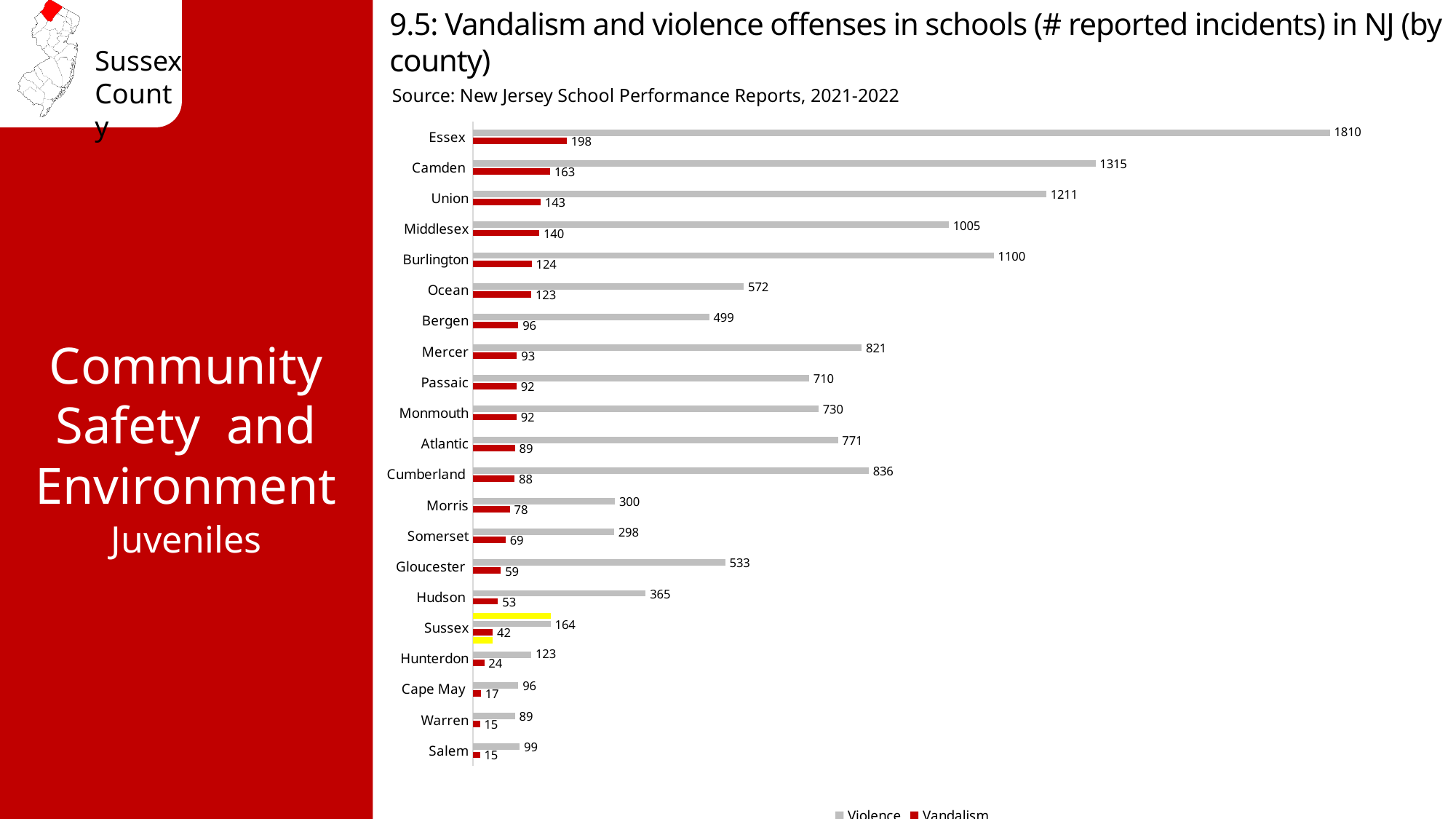
What is the Violence value for Essex? 1810 Which series is shown in red? Vandalism Which county has the highest Violence value? Essex Which is larger, the Violence value for Middlesex or for Burlington? Burlington How many series does the legend list? 2 Which county has the lowest Vandalism value? Warren and Salem (15 each) How many counties are shown on the chart? 21 What is the Violence value for Hunterdon? 123 What is the Vandalism value for Sussex? 42 What is the total of the Violence and Vandalism values for Sussex? 206 What is the difference between the Violence values for Camden and Union? 104 What kind of chart is shown? Bar chart